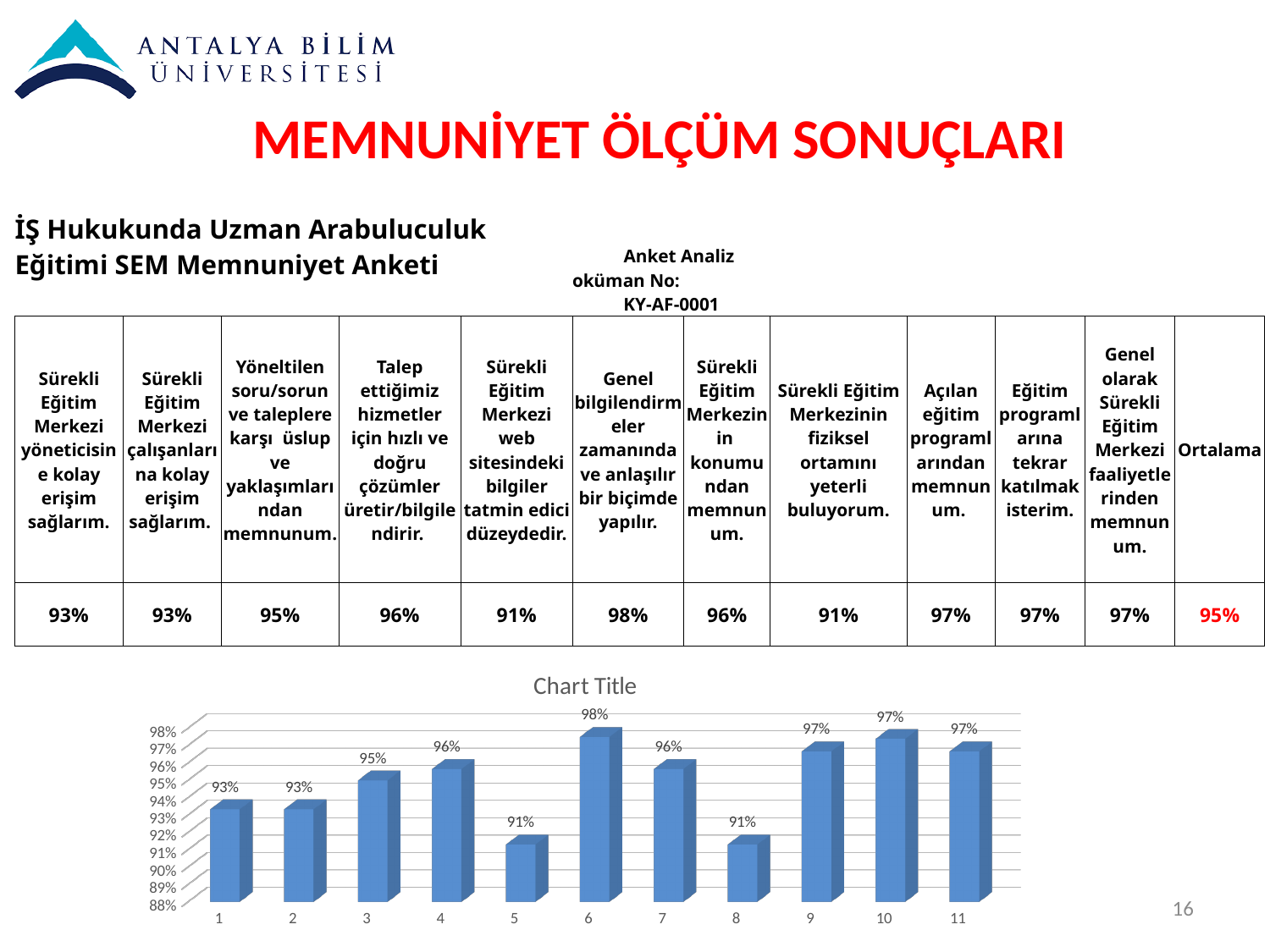
What is the difference between the values for category 6 and category 5? 7% What is the difference between the values for category 9 and category 1? 4% What is the value for category 6 in the chart? 98% What is the value for category 8 in the chart? 91% Which category has the highest value in the chart? 6 Is the value for category 10 greater or less than 95%? greater What is the value for category 3 in the chart? 95% How many categories are shown on the x axis of the chart? 11 Which is larger, the value for category 4 or the value for category 2? category 4 What kind of chart is shown on the slide? bar chart What is the title of the chart? Chart Title Is the value for category 5 greater or less than 93%? less